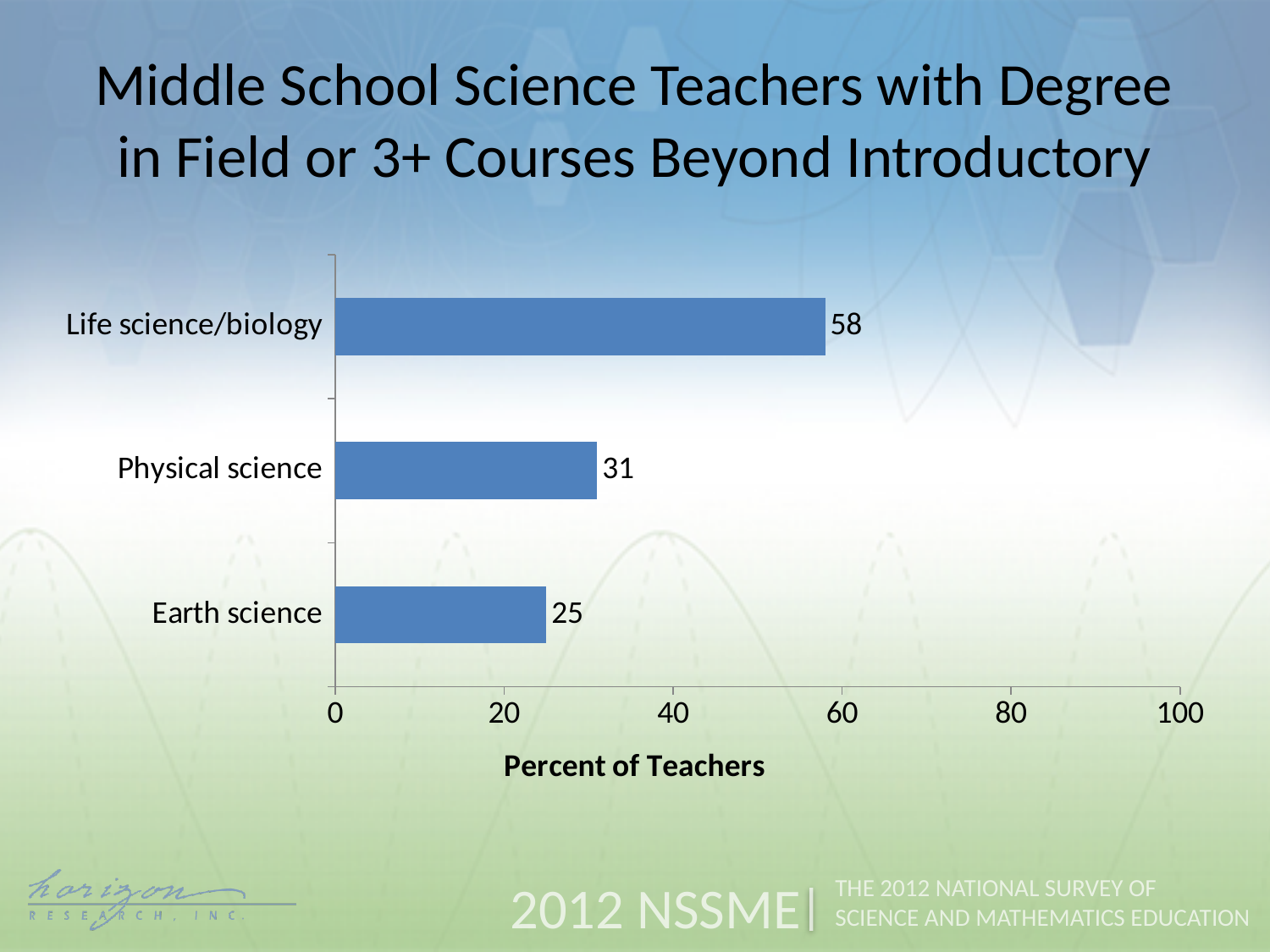
What is the value for Earth science? 25 Is the value for Life science/biology greater or less than 40? greater Which category has the highest value? Life science/biology What is the label of the horizontal axis? Percent of Teachers How many categories are shown in the chart? 3 What kind of chart is shown on the slide? bar chart What is the value for Life science/biology? 58 Which is larger, the value for Physical science or the value for Earth science? Physical science What is the value for Physical science? 31 What is the difference between the values for Life science/biology and Physical science? 27 What is the difference between the values for Physical science and Earth science? 6 Which category has the lowest value? Earth science